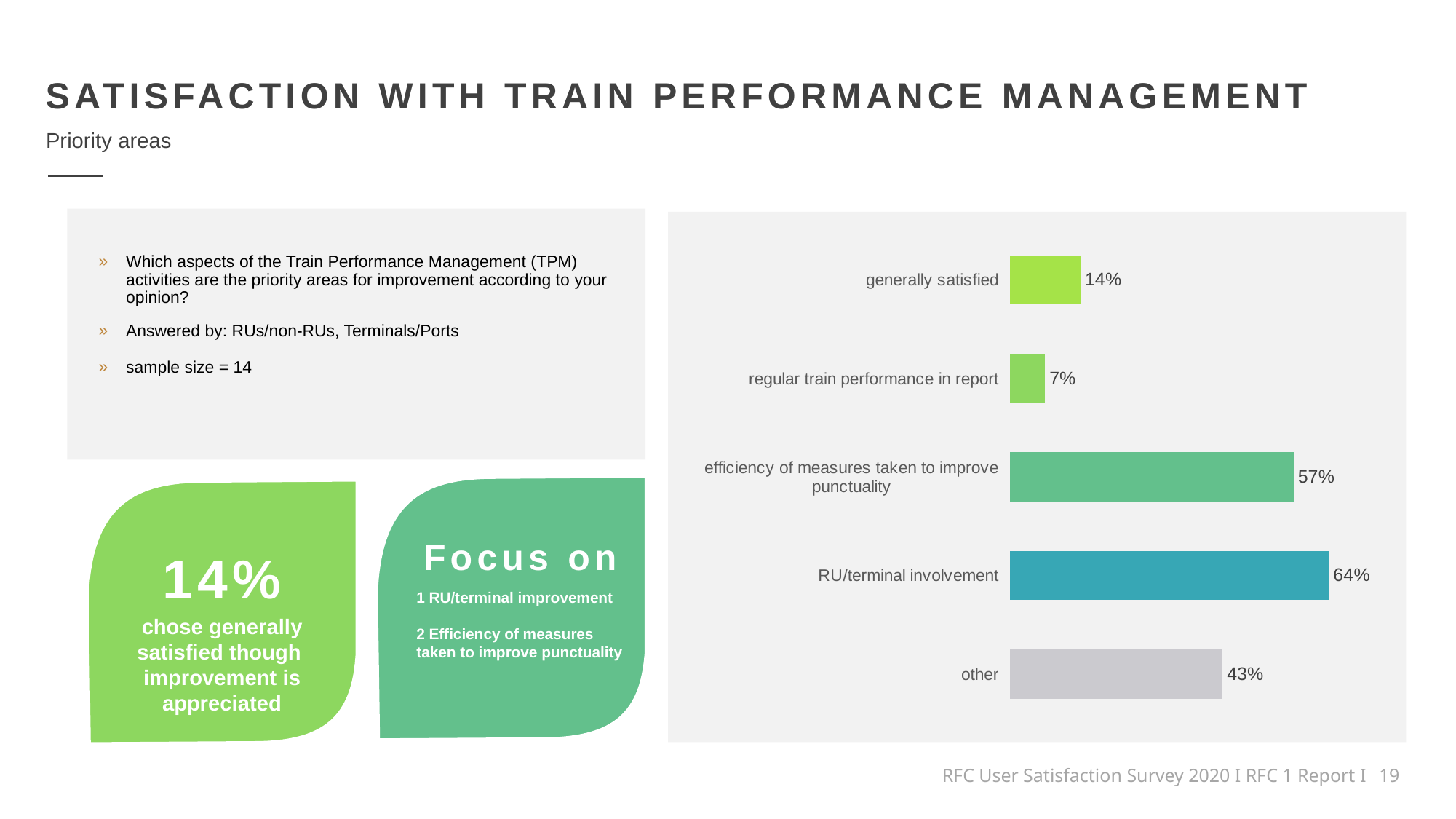
Which category has the highest value in the chart? RU/terminal involvement What is the difference between the values for 'RU/terminal involvement' and 'efficiency of measures taken to improve punctuality'? 7% What percentage of respondents chose 'RU/terminal involvement' as a priority area? 64% What is the difference between the values for 'generally satisfied' and 'regular train performance in report'? 7% What is the value for the 'other' category? 43% What colour is the bar for 'RU/terminal involvement'? Teal/blue How many categories are shown in the bar chart? 5 What is the value shown for 'efficiency of measures taken to improve punctuality'? 57% What percentage is shown for 'regular train performance in report'? 7% What type of chart is shown on the slide? Bar chart Which is larger: the value for 'other' or the value for 'generally satisfied'? other Which category has the lowest value in the chart? regular train performance in report